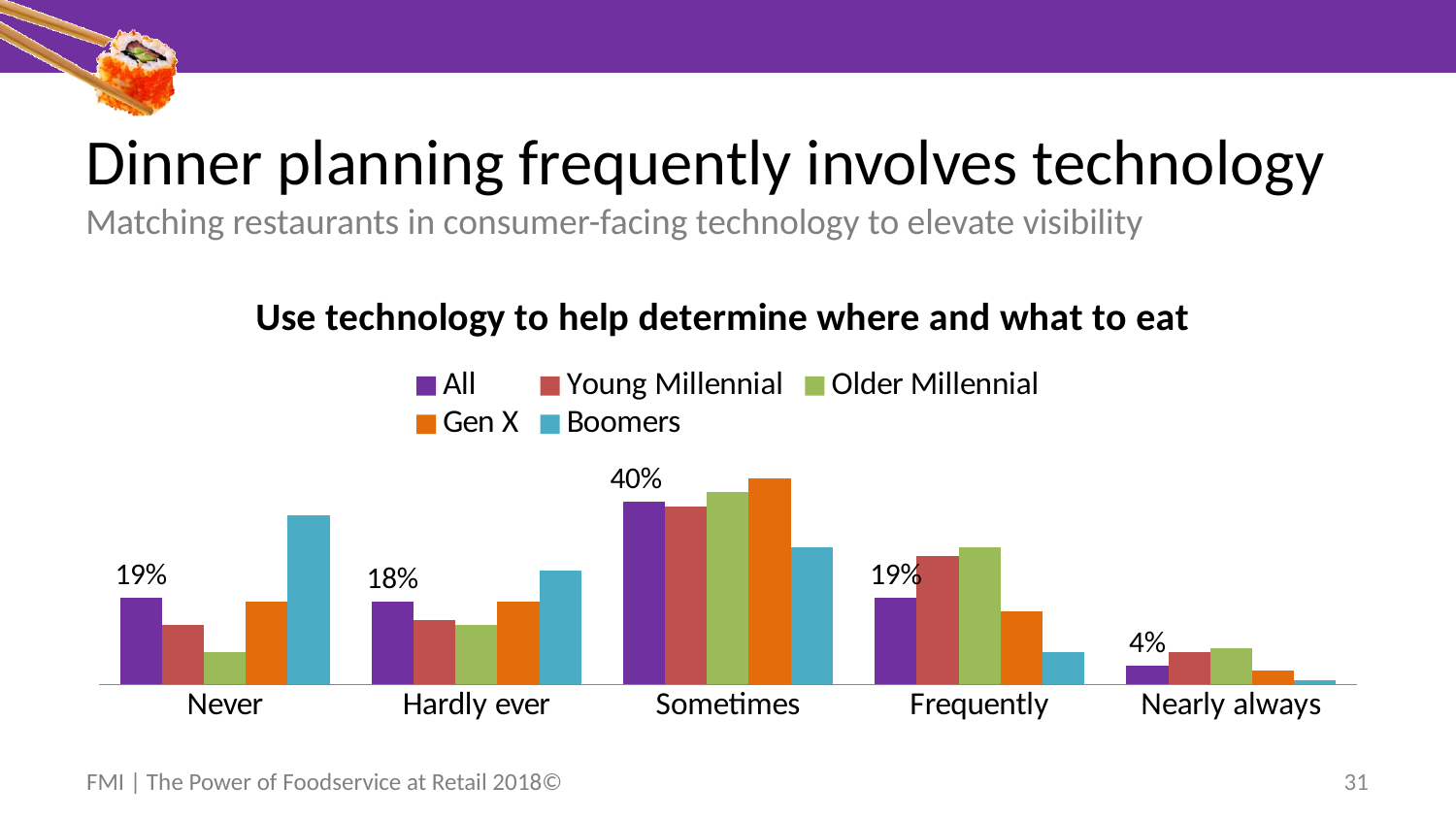
In the Never category, which series has the tallest bar? Boomers In the Sometimes category, which series has the tallest bar? Gen X What is the value for All in the Nearly always category? 4% For the All series, which is larger: the value for Never or the value for Hardly ever? Never What kind of chart is shown on the slide? Bar chart For the All series, which category has the highest value? Sometimes How many categories are shown on the x axis? 5 What is the difference between the All values for Sometimes and Nearly always? 36 percentage points How many series does the legend list? 5 For the All series, which category has the lowest value? Nearly always What is the value for All in the Hardly ever category? 18% What is the value for All in the Sometimes category? 40%